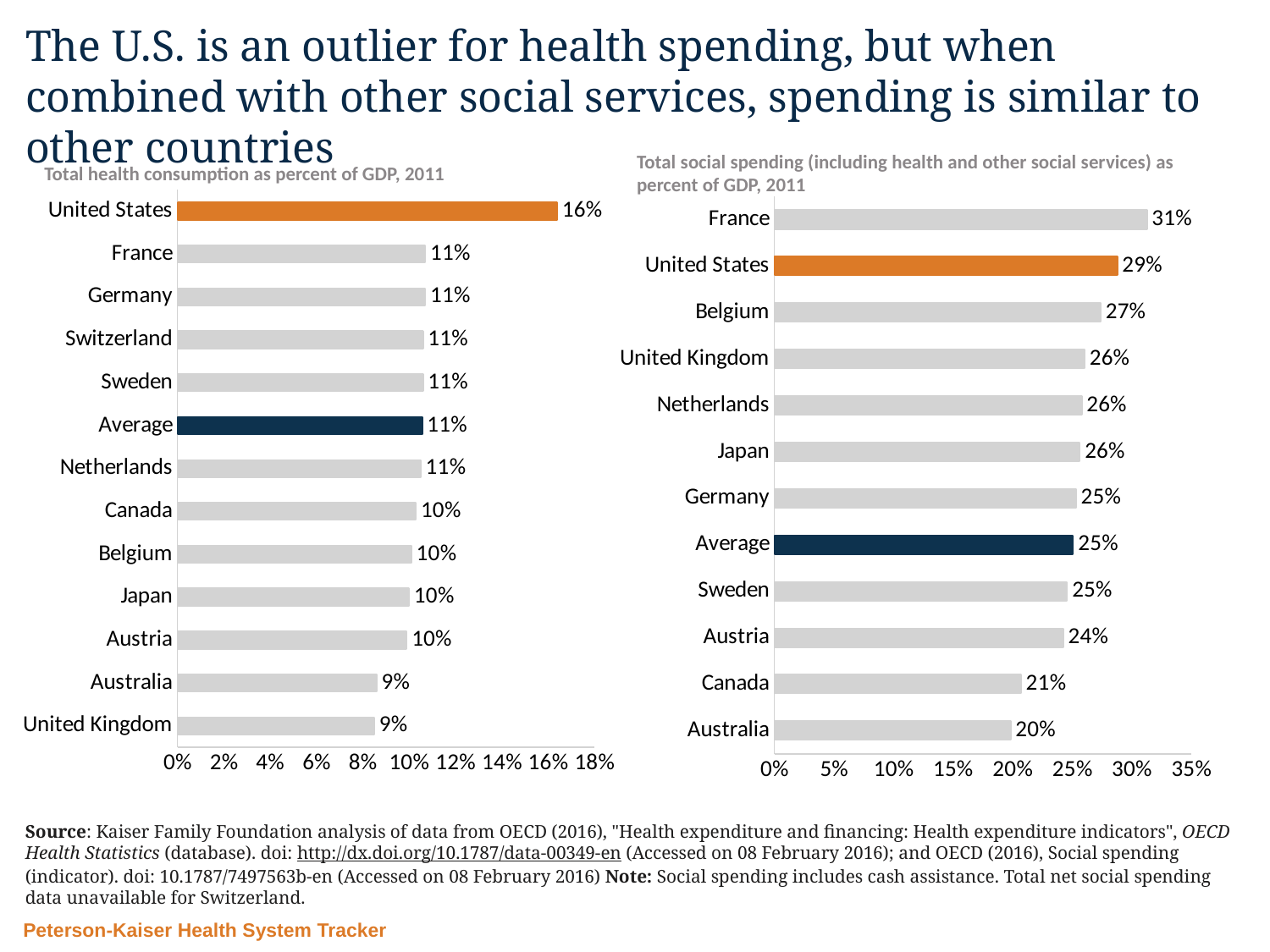
In the left chart (Total health consumption as percent of GDP, 2011), is the value for the United States greater or less than 14%? greater In the left chart (Total health consumption as percent of GDP, 2011), what is the value for the United States? 16% How many categories are shown in the left chart (Total health consumption as percent of GDP, 2011)? 13 In the left chart (Total health consumption as percent of GDP, 2011), what is the difference between the United States and the Average? 5% In the right chart (Total social spending as percent of GDP, 2011), what is the difference between France and the United States? 2% In the right chart (Total social spending as percent of GDP, 2011), which is larger, the value for Belgium or the value for Canada? Belgium In the right chart (Total social spending as percent of GDP, 2011), which country has the lowest value? Australia In the right chart (Total social spending as percent of GDP, 2011), what is the value for the United States? 29% What type of chart is the right chart (Total social spending as percent of GDP, 2011)? Bar chart How many categories are shown in the right chart (Total social spending as percent of GDP, 2011)? 12 In the right chart (Total social spending as percent of GDP, 2011), what is the value for France? 31% In the left chart (Total health consumption as percent of GDP, 2011), which country has the highest value? United States